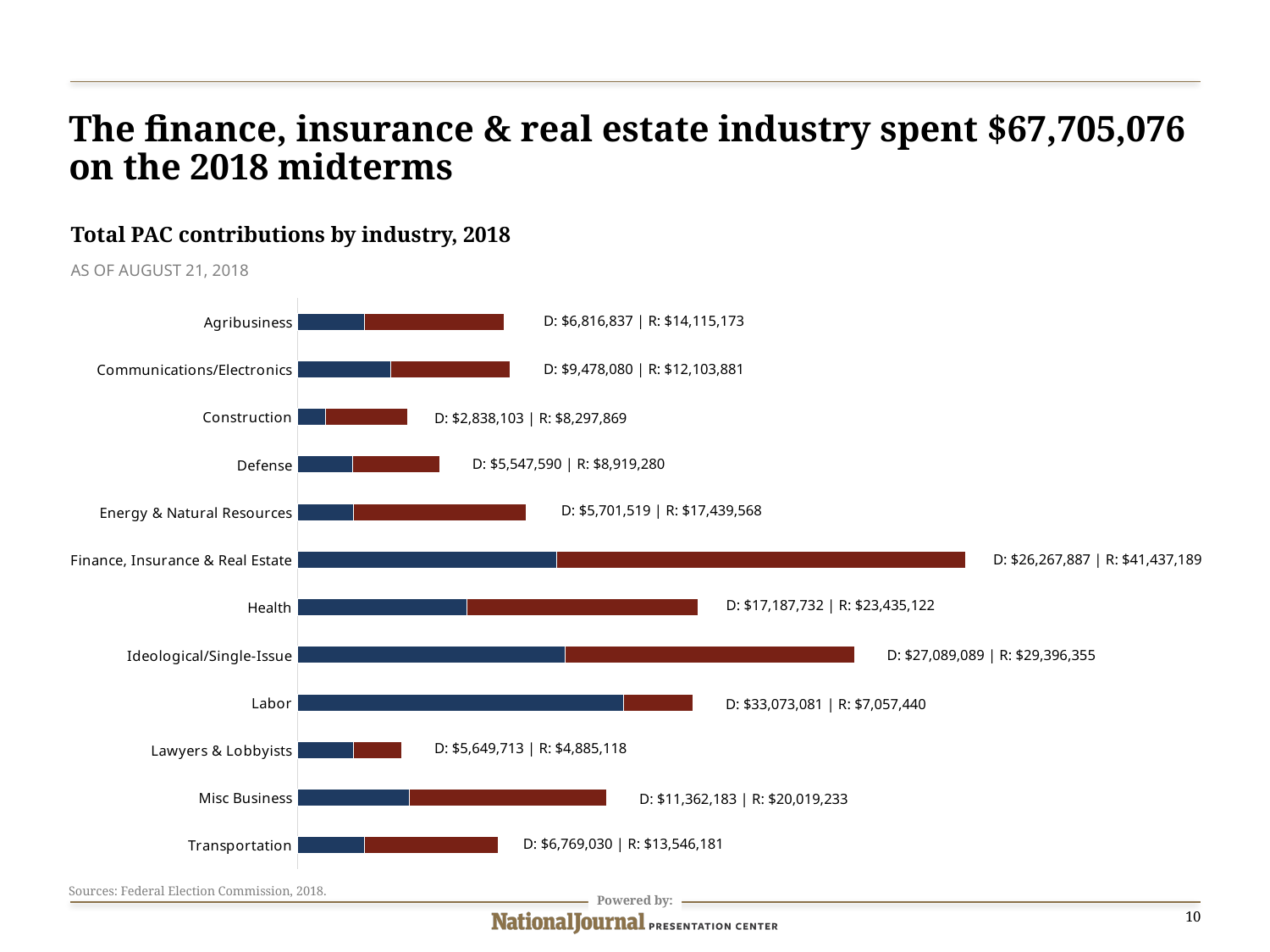
Which industry has the lowest Republican (R) PAC contribution value? Lawyers & Lobbyists What is the Republican (R) PAC contribution value for Energy & Natural Resources? $17,439,568 What is the total PAC contribution (D plus R) for Finance, Insurance & Real Estate? $67,705,076 What is the Democratic (D) PAC contribution value for Construction? $2,838,103 How many industries are shown in the chart? 12 What is the Democratic (D) PAC contribution value for Labor? $33,073,081 Which industry has the highest Republican (R) PAC contribution value? Finance, Insurance & Real Estate Which industry has the highest Democratic (D) PAC contribution value? Labor What kind of chart is shown on the slide? Bar chart What is the difference between the R and D values for Finance, Insurance & Real Estate? $15,169,302 What is the title of the chart? Total PAC contributions by industry, 2018 Which is larger for Lawyers & Lobbyists, the D value or the R value? D